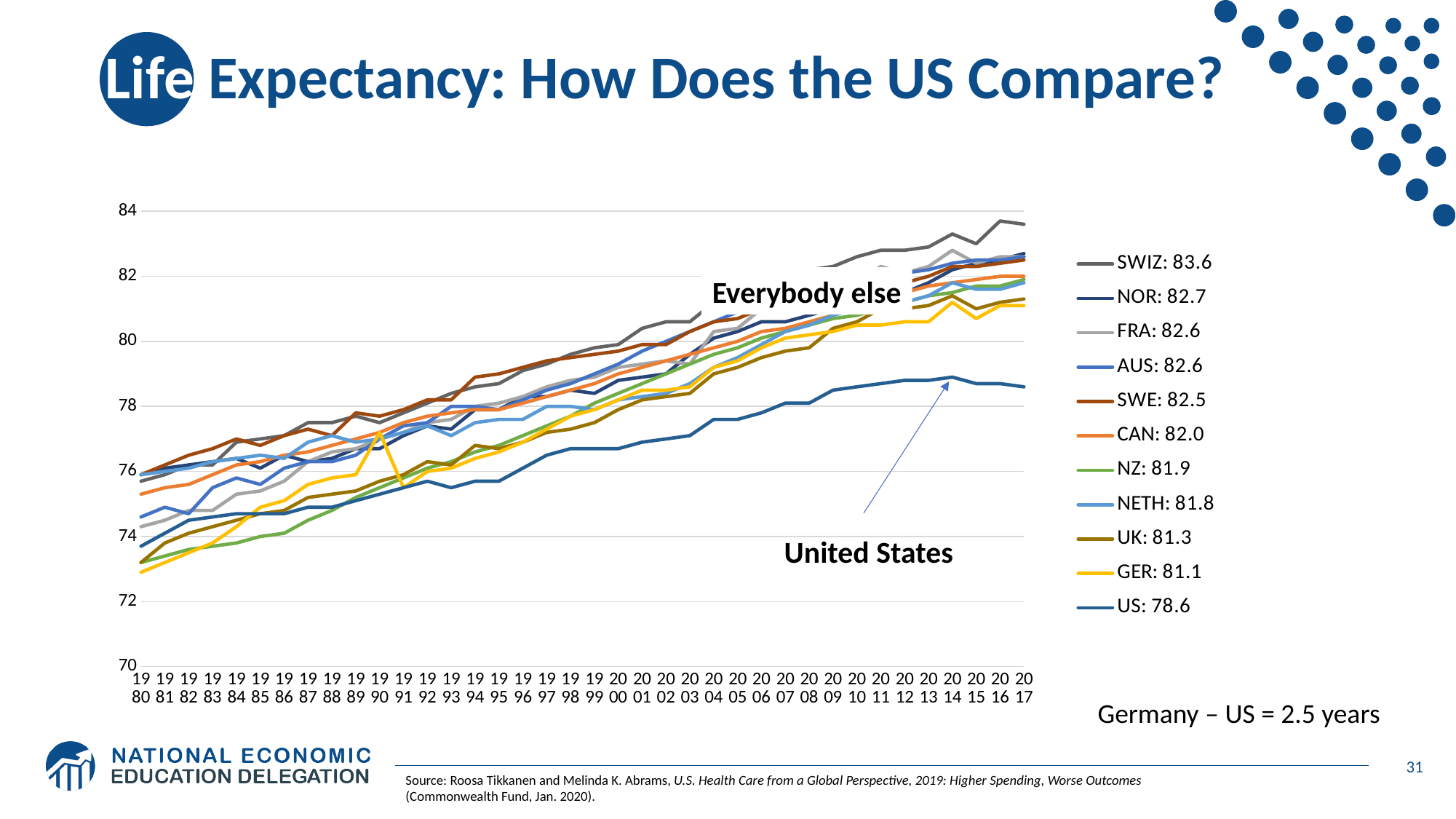
What kind of chart is shown on the slide? line chart What value is shown in the legend for SWIZ? 83.6 Which country has the highest value in the legend? SWIZ Which has the larger legend value, UK or NETH? NETH Is the value for the US line in 2017 greater or less than 80? less What is the difference between the legend values for GER and US? 2.5 What value is shown in the legend for CAN? 82.0 Which country has the lowest value in the legend? US What is the difference between the legend values for SWIZ and US? 5.0 What value is shown in the legend for US? 78.6 How many series does the legend list? 11 Does the US line rise or fall from 1980 to 2017? rise